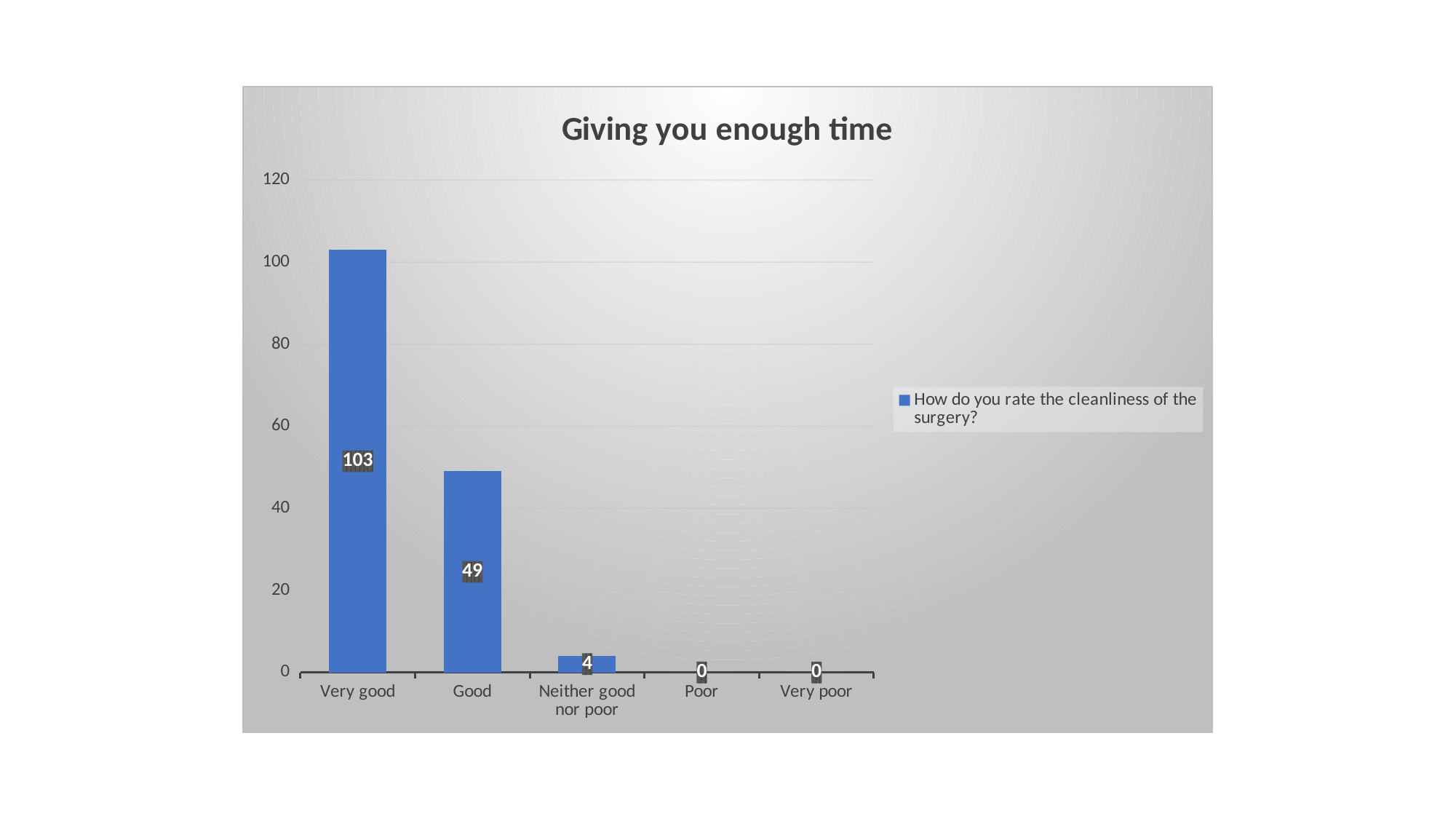
Is the value for Very good greater or less than 100? greater What is the value for Good? 49 What kind of chart is shown? bar chart What is the value for Very good? 103 What is the difference between the values for Very good and Good? 54 What is the value for Neither good nor poor? 4 Which category has the highest value? Very good How many series does the legend list? 1 What is the title of the chart? Giving you enough time How many categories are shown on the x axis? 5 What is the value for Poor? 0 Which is larger, the value for Good or the value for Neither good nor poor? Good